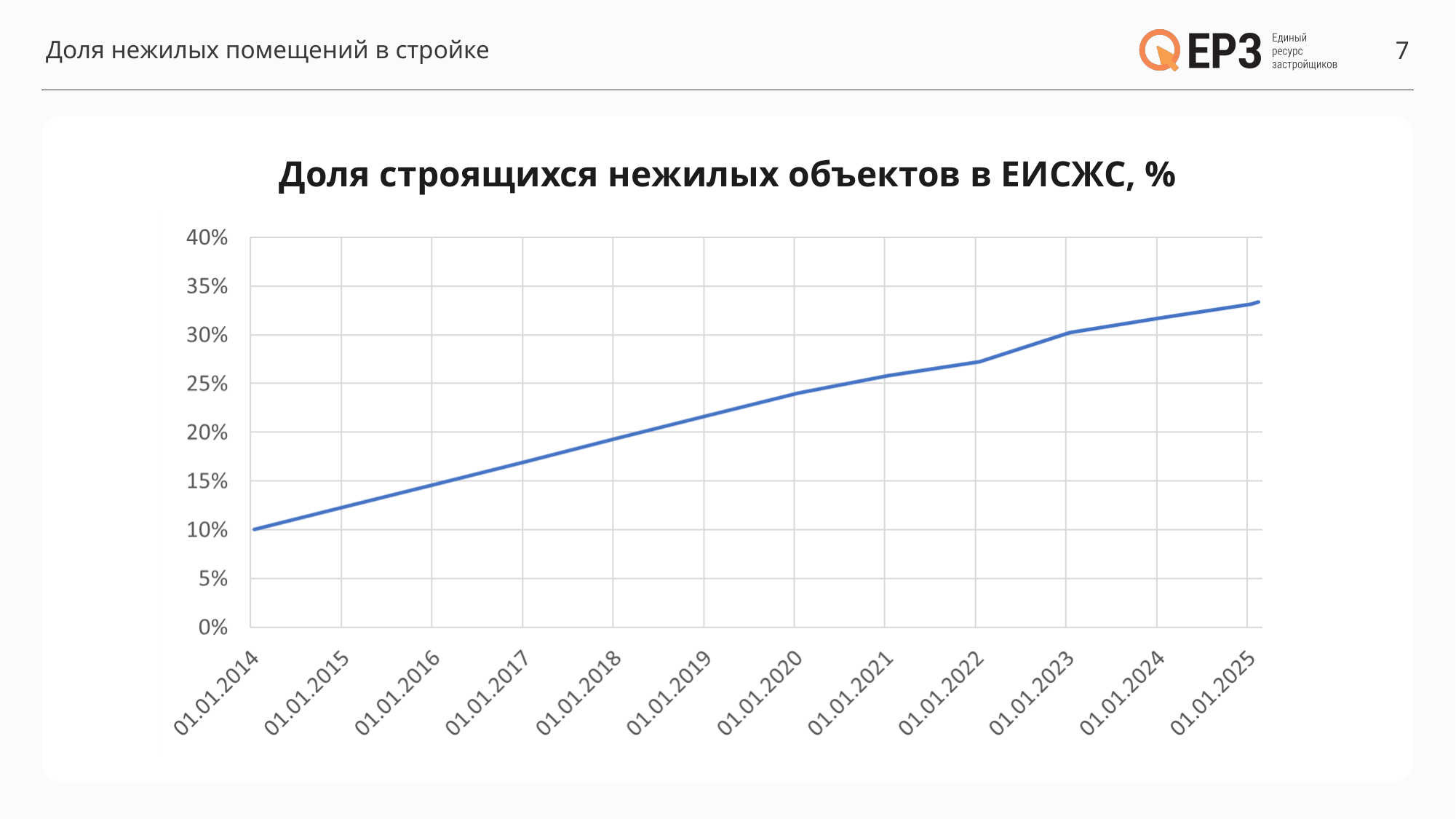
What kind of chart is shown on the slide? line chart Is the value for 01.01.2017 greater or less than 15%? greater What is the title of the chart? Доля строящихся нежилых объектов в ЕИСЖС, % Which date has the lowest value? 01.01.2014 Which date has the highest value? 01.01.2025 Is the value for 01.01.2022 greater or less than 30%? less Is the value for 01.01.2020 greater or less than 25%? less Which is larger, the value for 01.01.2019 or the value for 01.01.2021? 01.01.2021 Do the values rise or fall from 01.01.2014 to 01.01.2025? rise